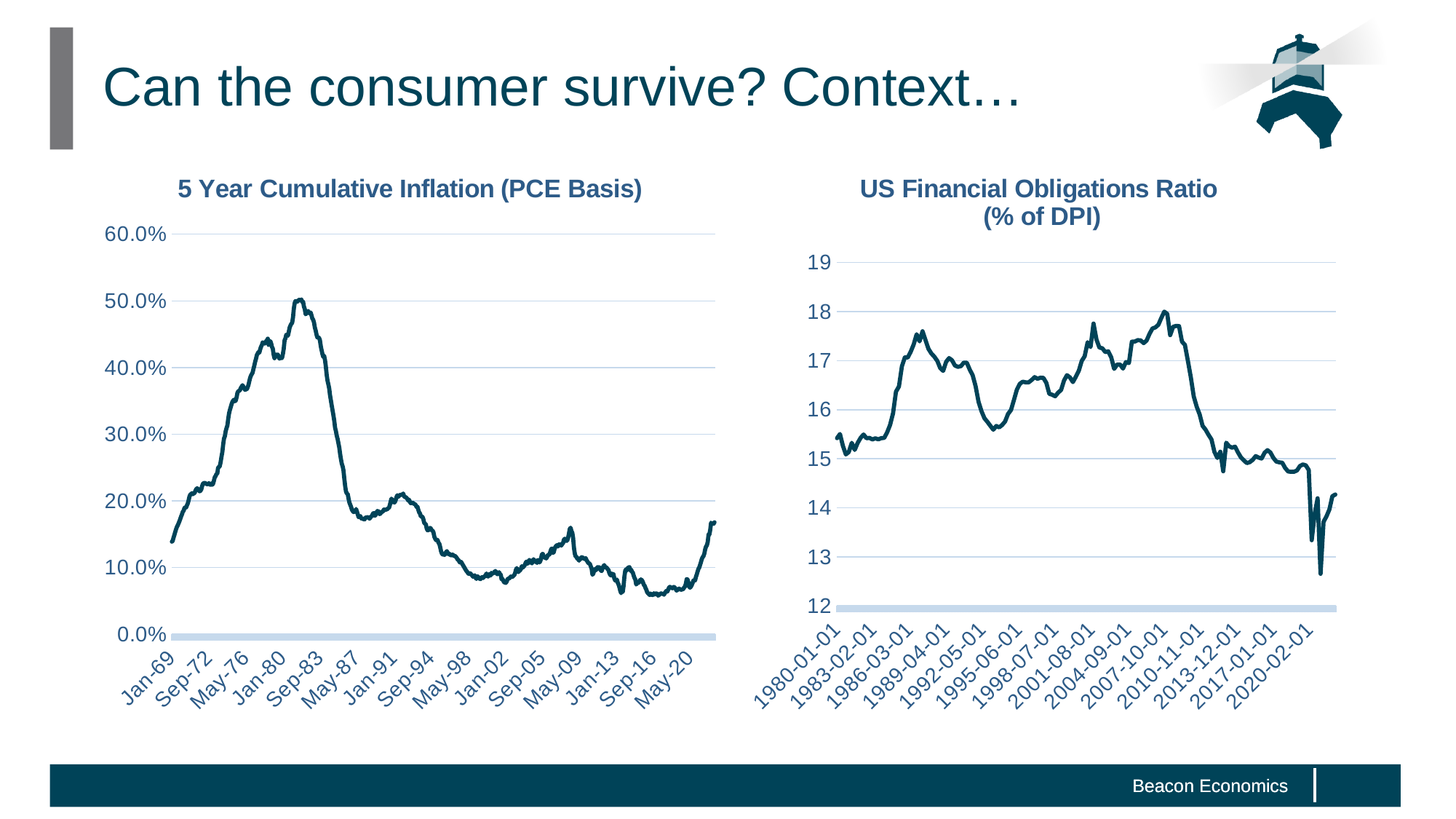
What kind of chart is the '5 Year Cumulative Inflation (PCE Basis)' chart? line chart In the '5 Year Cumulative Inflation (PCE Basis)' chart, is the value at Sep-16 greater or less than 10.0%? less In the '5 Year Cumulative Inflation (PCE Basis)' chart, is the peak value reached around Sep-83 greater or less than 40.0%? greater In the '5 Year Cumulative Inflation (PCE Basis)' chart, does the line rise or fall between Jan-69 and Jan-80? rise In the '5 Year Cumulative Inflation (PCE Basis)' chart, does the line rise or fall between Sep-83 and May-87? fall In the '5 Year Cumulative Inflation (PCE Basis)' chart, is the value at Jan-69 greater or less than 20.0%? less What is the highest value shown on the y axis of the 'US Financial Obligations Ratio (% of DPI)' chart? 19 What is the title of the chart on the left side of the slide? 5 Year Cumulative Inflation (PCE Basis) In the 'US Financial Obligations Ratio (% of DPI)' chart, does the line rise or fall between 2007-10-01 and 2010-11-01? fall What kind of chart is the 'US Financial Obligations Ratio (% of DPI)' chart? line chart